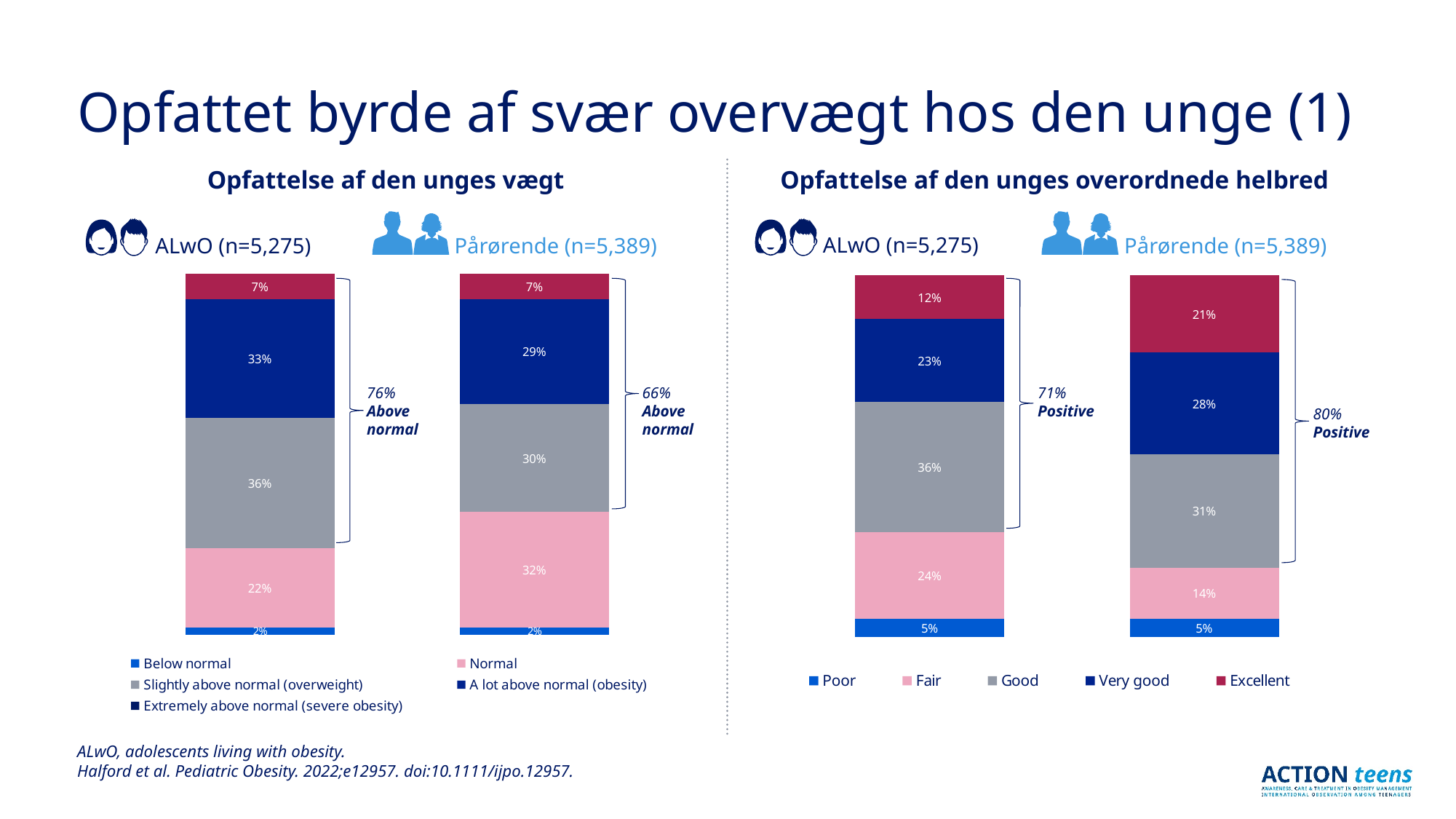
In the 'Opfattelse af den unges vægt' chart, what percentage of ALwO respondents rated the weight as 'Slightly above normal (overweight)'? 36% In the 'Opfattelse af den unges overordnede helbred' chart, which category is the largest for ALwO? Good How many categories does the legend of the 'Opfattelse af den unges overordnede helbred' chart list? 5 In the 'Opfattelse af den unges vægt' chart, what share of ALwO responses is labelled 'Above normal'? 76% What type of chart is used on this slide? Stacked bar chart In the 'Opfattelse af den unges overordnede helbred' chart, what is the difference between the 'Fair' values for ALwO and Pårørende? 10 percentage points In the 'Opfattelse af den unges vægt' chart, what is the difference between the 'A lot above normal (obesity)' values for ALwO and Pårørende? 4 percentage points In the 'Opfattelse af den unges overordnede helbred' chart, what percentage of Pårørende rated the health as 'Excellent'? 21% In the 'Opfattelse af den unges vægt' chart, which group has the larger 'Normal' share, ALwO or Pårørende? Pårørende In the 'Opfattelse af den unges vægt' chart, what percentage of Pårørende respondents rated the weight as 'Normal'? 32% In the 'Opfattelse af den unges overordnede helbred' chart, which category is the smallest for Pårørende? Poor In the 'Opfattelse af den unges overordnede helbred' chart, what share of Pårørende responses is labelled 'Positive'? 80%